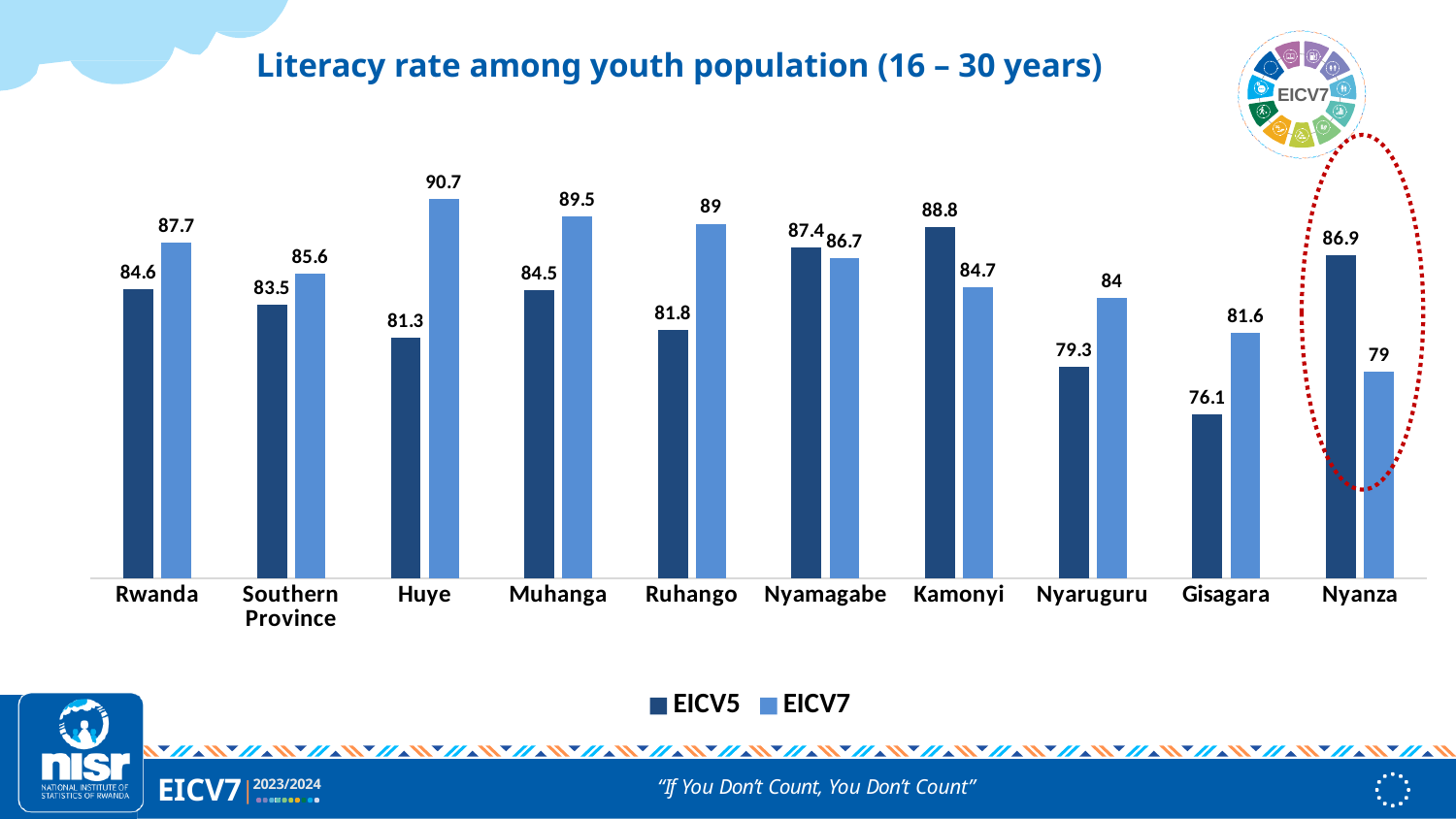
Which district or region has the highest EICV7 literacy rate? Huye Which category has the lowest EICV5 literacy rate? Gisagara What is the EICV5 literacy rate for Gisagara? 76.1 What is the EICV7 value for Nyanza? 79 What is the difference between the EICV7 and EICV5 literacy rates for Huye? 9.4 What kind of chart is shown on the slide? Bar chart For Kamonyi, which is larger, the EICV5 or the EICV7 value? EICV5 Which category has the lowest EICV7 literacy rate? Nyanza How many series does the legend list? 2 What is the EICV7 literacy rate for Huye? 90.7 By how much did the literacy rate in Nyanza fall from EICV5 to EICV7? 7.9 How many categories are shown on the x axis? 10